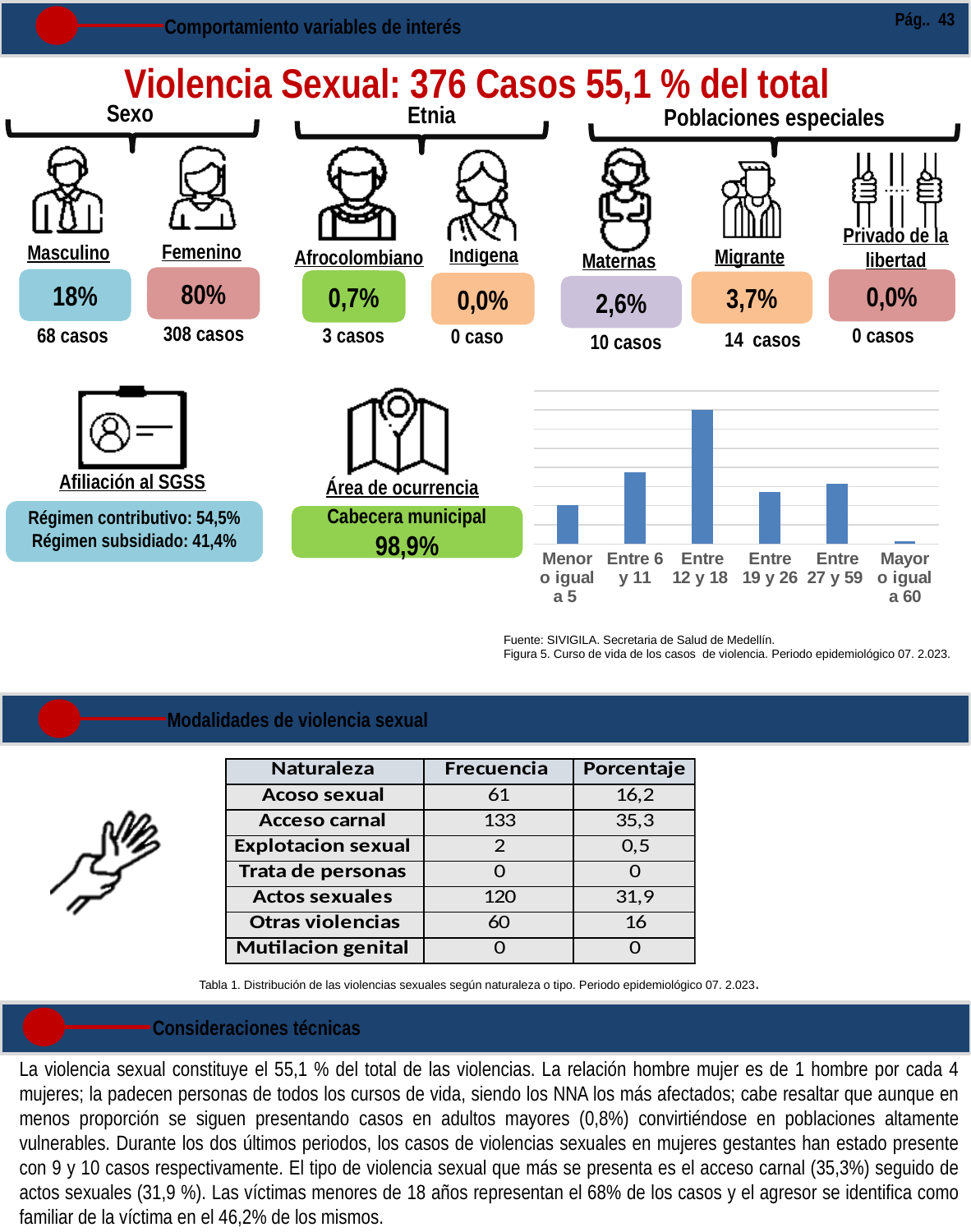
What is the label of the first category on the x axis of the bar chart? Menor o igual a 5 In the bar chart, which is larger: the bar for Menor o igual a 5 or the bar for Entre 6 y 11? Entre 6 y 11 Do the bars rise or fall from Menor o igual a 5 to Entre 12 y 18? rise What colour are the bars in the chart? blue In the bar chart, which is larger: the bar for Entre 6 y 11 or the bar for Entre 19 y 26? Entre 6 y 11 In the bar chart, which is larger: the bar for Menor o igual a 5 or the bar for Mayor o igual a 60? Menor o igual a 5 How many age-group categories does the bar chart show? 6 Which age group has the lowest bar in the chart? Mayor o igual a 60 Which age group has the second highest bar in the chart? Entre 6 y 11 Which age group has the highest bar in the chart? Entre 12 y 18 What kind of chart is shown on the slide? bar chart